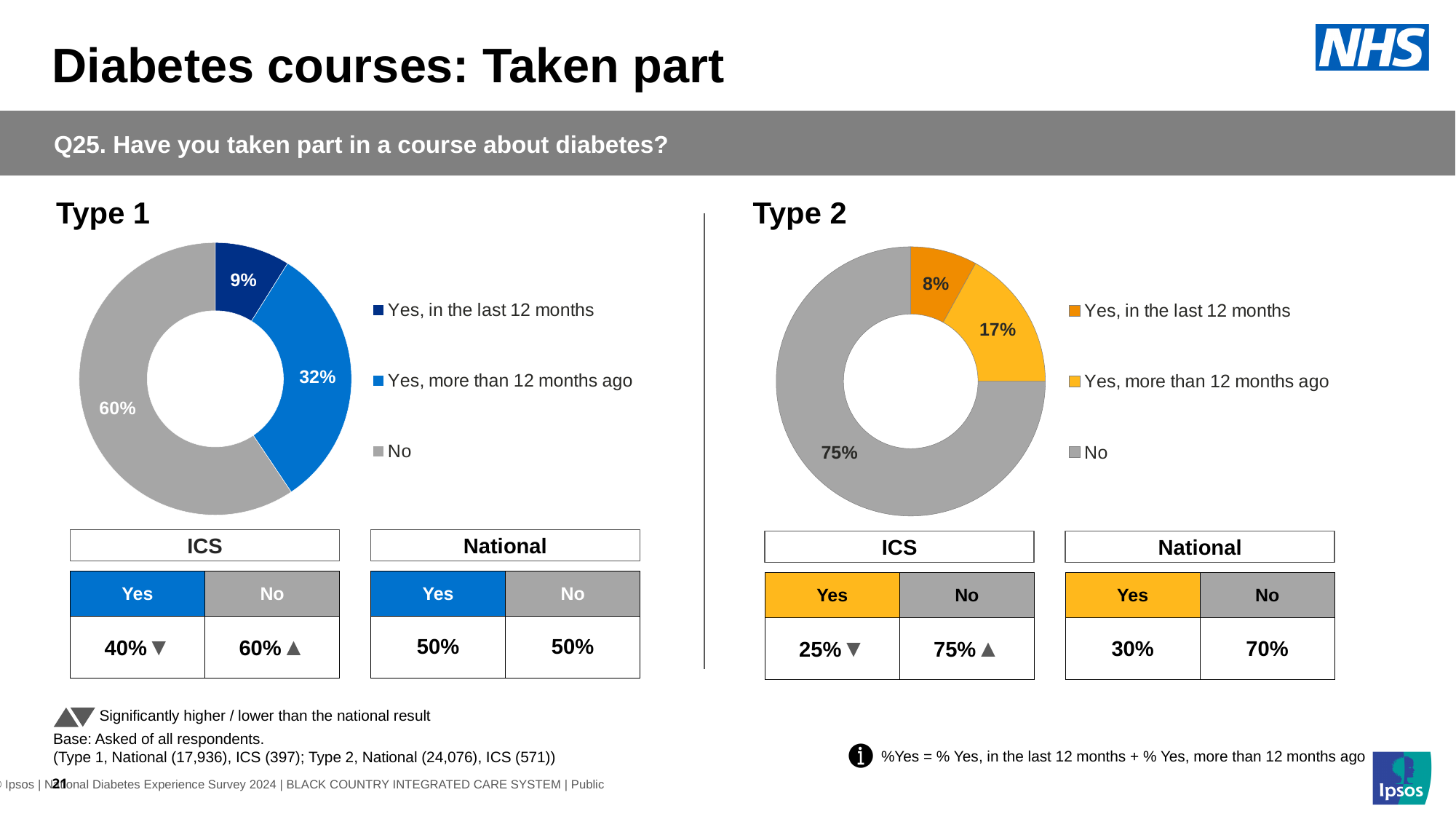
How many entries does the legend of the Type 1 chart list? 3 In the Type 1 chart, which response has the smallest share? Yes, in the last 12 months How many categories does the Type 2 chart show? 3 What kind of chart is used for Type 1? Doughnut chart Which is larger in the Type 1 chart: 'Yes, more than 12 months ago' or 'Yes, in the last 12 months'? Yes, more than 12 months ago In the Type 2 chart, what is the difference between the 'No' share and the 'Yes, more than 12 months ago' share? 58% In the Type 2 chart, what colour is the 'No' segment? Grey In the Type 1 chart, what is the combined share of the two 'Yes' responses? 41% In the Type 1 chart, what percentage of respondents answered 'Yes, in the last 12 months'? 9% In the Type 1 chart, what percentage of respondents answered 'No'? 60% In the Type 2 chart, which response has the largest share? No In the Type 2 chart, what percentage of respondents answered 'Yes, more than 12 months ago'? 17%